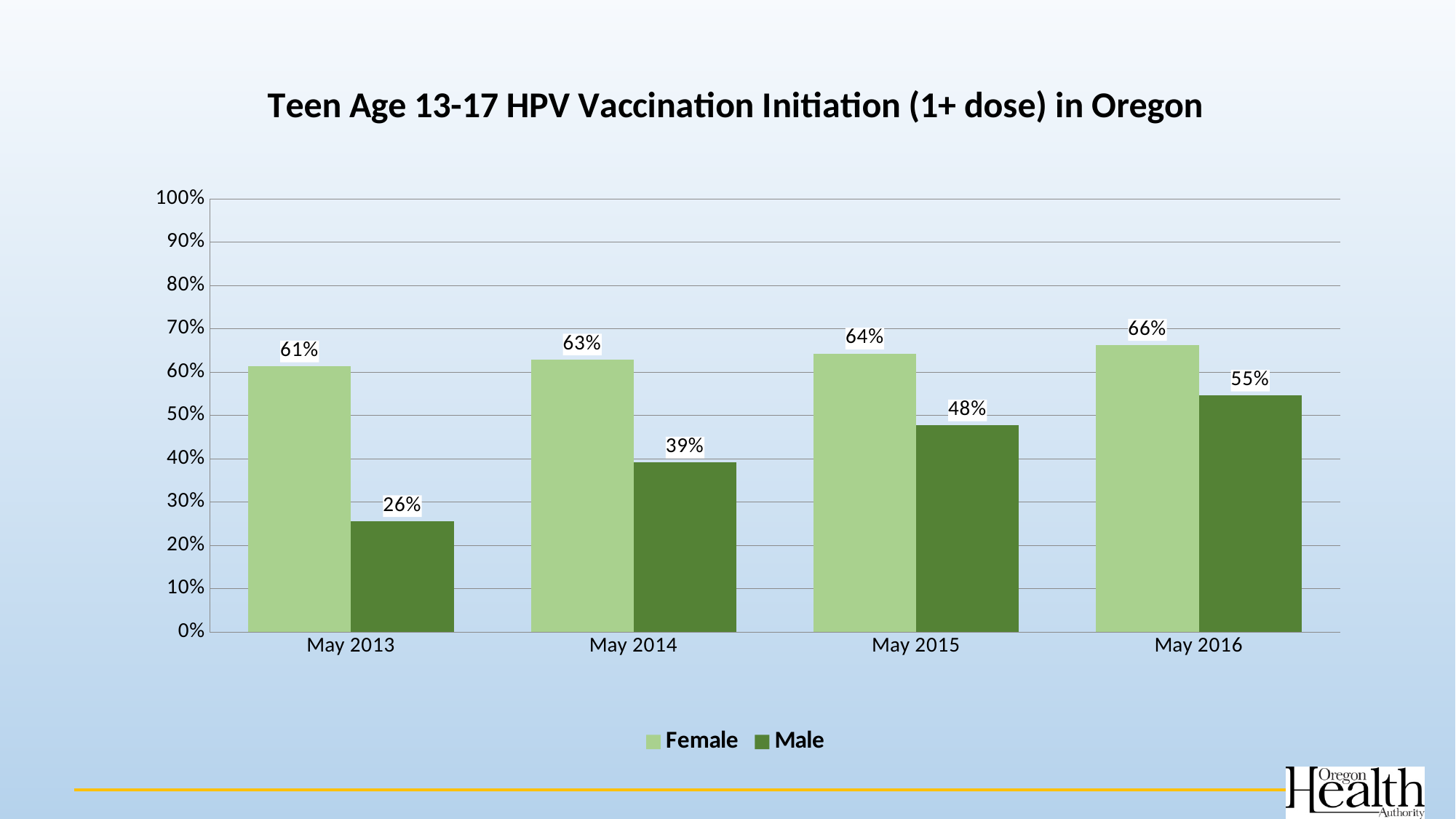
What is the Female value for May 2014? 63% How many years are shown on the x axis? 4 Is the Male value for May 2015 greater or less than 40%? greater Do the Male values rise or fall from May 2013 to May 2016? rise Which is larger in May 2014, the Female value or the Male value? Female How many series does the legend list? 2 In which year is the Female value lowest? May 2013 What is the difference between the Female and Male values in May 2015? 16% In which year is the Male value highest? May 2016 What kind of chart is shown? bar chart What is the Male value for May 2016? 55% What is the Male value for May 2013? 26%